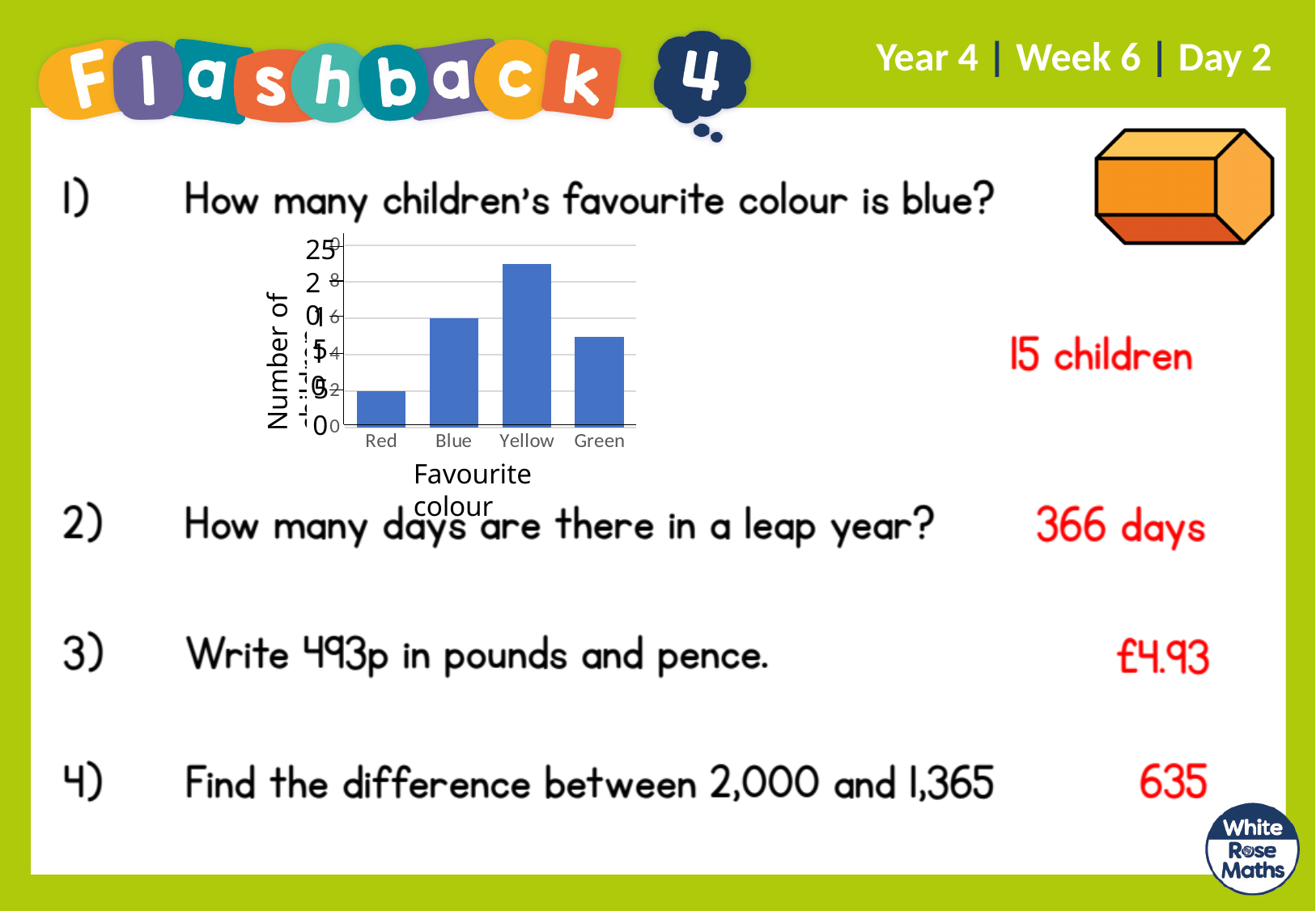
Is the bar for Yellow or the bar for Blue taller in the chart? Yellow Which favourite colour has the lowest bar in the chart? Red Is the bar for Blue or the bar for Green taller in the chart? Blue Is the bar for Yellow or the bar for Red taller in the chart? Yellow Which favourite colour has the highest bar in the chart? Yellow How many categories are shown on the x axis of the chart? 4 What kind of chart is shown on the slide? bar chart According to the slide, how many children's favourite colour is blue? 15 children What colour are the bars in the chart? blue What is the title of the x axis of the chart? Favourite colour